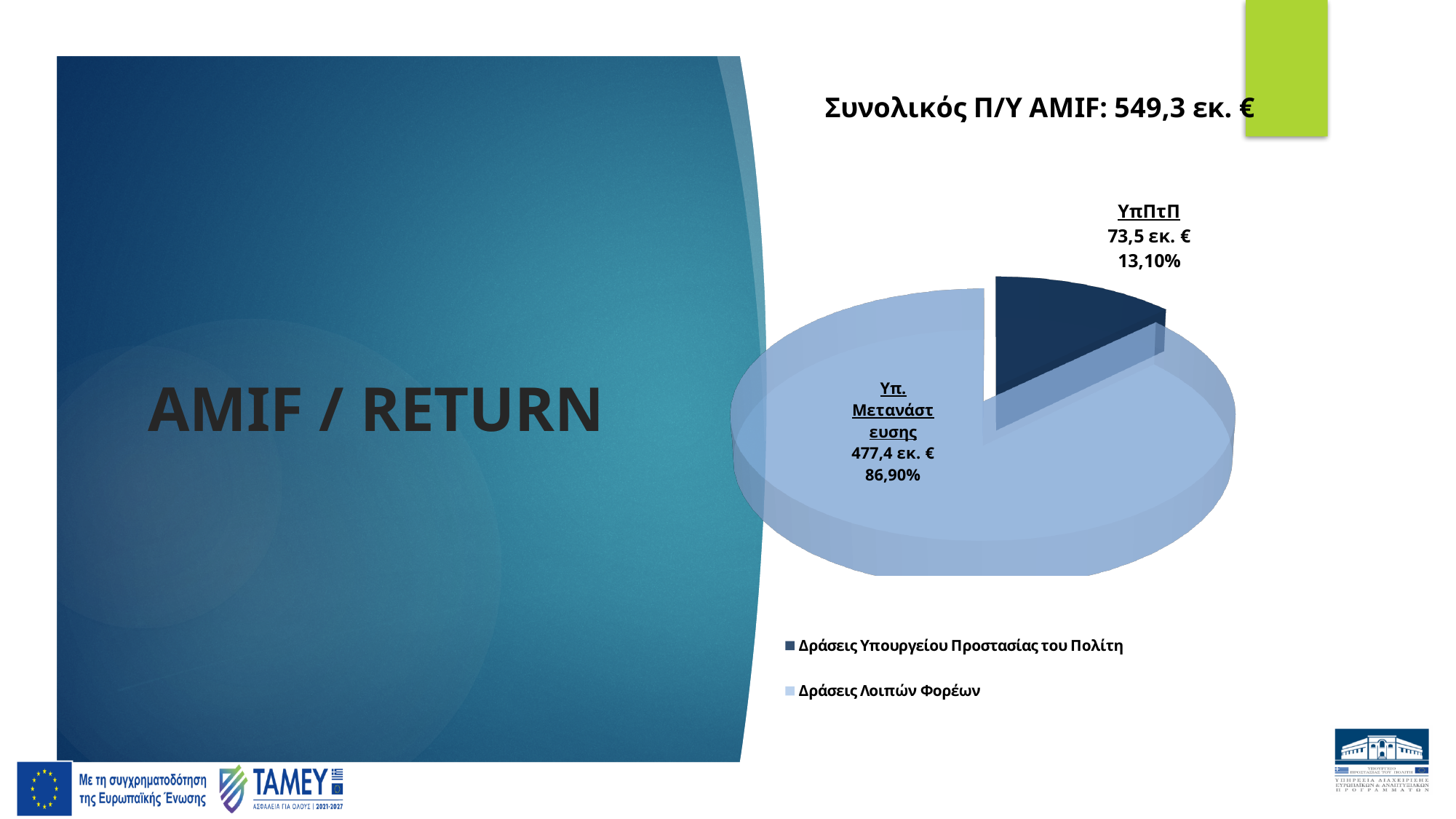
Which is larger, the ΥπΠτΠ slice or the Υπ. Μετανάστευσης slice? Υπ. Μετανάστευσης How many entries does the chart legend list? 2 What is the value shown for the ΥπΠτΠ slice of the pie chart? 73,5 εκ. € What share of the pie does the Υπ. Μετανάστευσης slice represent? 86,90% What kind of chart is shown on the slide? Pie chart Which slice of the pie chart is the largest? Υπ. Μετανάστευσης What is the value shown for the Υπ. Μετανάστευσης slice of the pie chart? 477,4 εκ. € What share of the pie does the ΥπΠτΠ slice represent? 13,10% Which slice of the pie chart is the smallest? ΥπΠτΠ How many slices does the pie chart have? 2 What total AMIF budget is stated in the chart title? 549,3 εκ. € What is the difference in percentage points between the Υπ. Μετανάστευσης share and the ΥπΠτΠ share? 73,80%